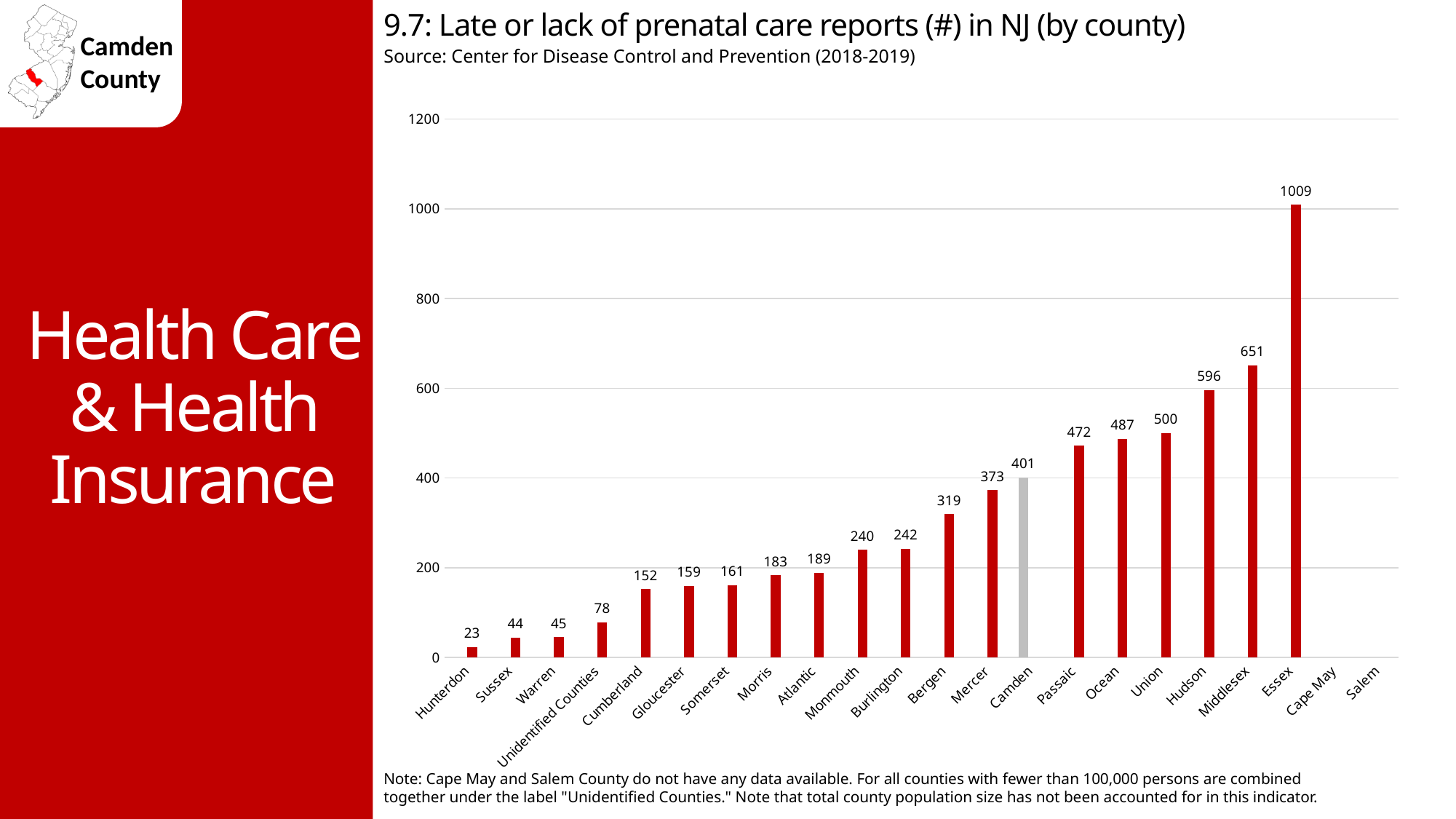
Is the value for Bergen greater or less than 400? less What is the difference between the values for Essex and Middlesex? 358 Which has a higher value, Hudson or Union? Hudson Which county has the highest number of late or lack of prenatal care reports? Essex Which two counties on the x axis have no bar because no data is available? Cape May and Salem What is the value shown for Essex County? 1009 Do the bar values rise or fall from Hunterdon to Essex along the x axis? Rise What is the value shown for Unidentified Counties? 78 Which county with a plotted bar has the lowest number of reports? Hunterdon What type of chart is shown on the slide? Bar chart What is the number of late or lack of prenatal care reports for Camden County? 401 What is the difference between the values for Camden and Mercer? 28